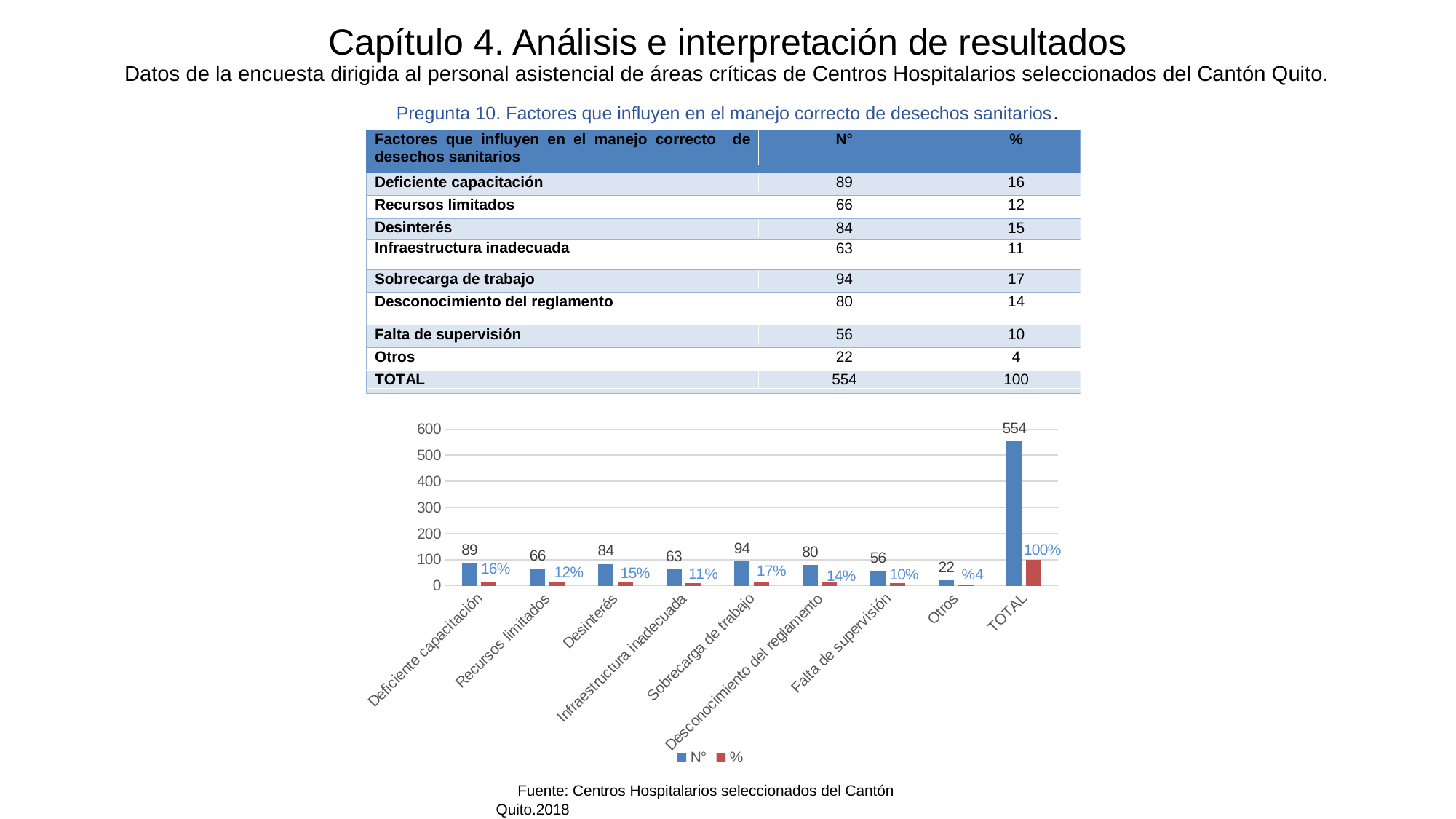
How many categories are shown on the x axis of the chart? 9 How many series does the legend list? 2 What kind of chart is shown on the slide? bar chart Excluding TOTAL, which category has the highest N° value? Sobrecarga de trabajo Which category has the lowest N° value? Otros What percentage is shown for Desinterés in the chart? 15% Is the N° value for TOTAL greater or less than 500? greater Which has a larger N° value, Desinterés or Desconocimiento del reglamento? Desinterés What is the difference between the N° values for Deficiente capacitación and Recursos limitados? 23 What is the N° value for Falta de supervisión? 56 What is the N° value for Sobrecarga de trabajo in the chart? 94 What are the two series named in the legend? N° and %